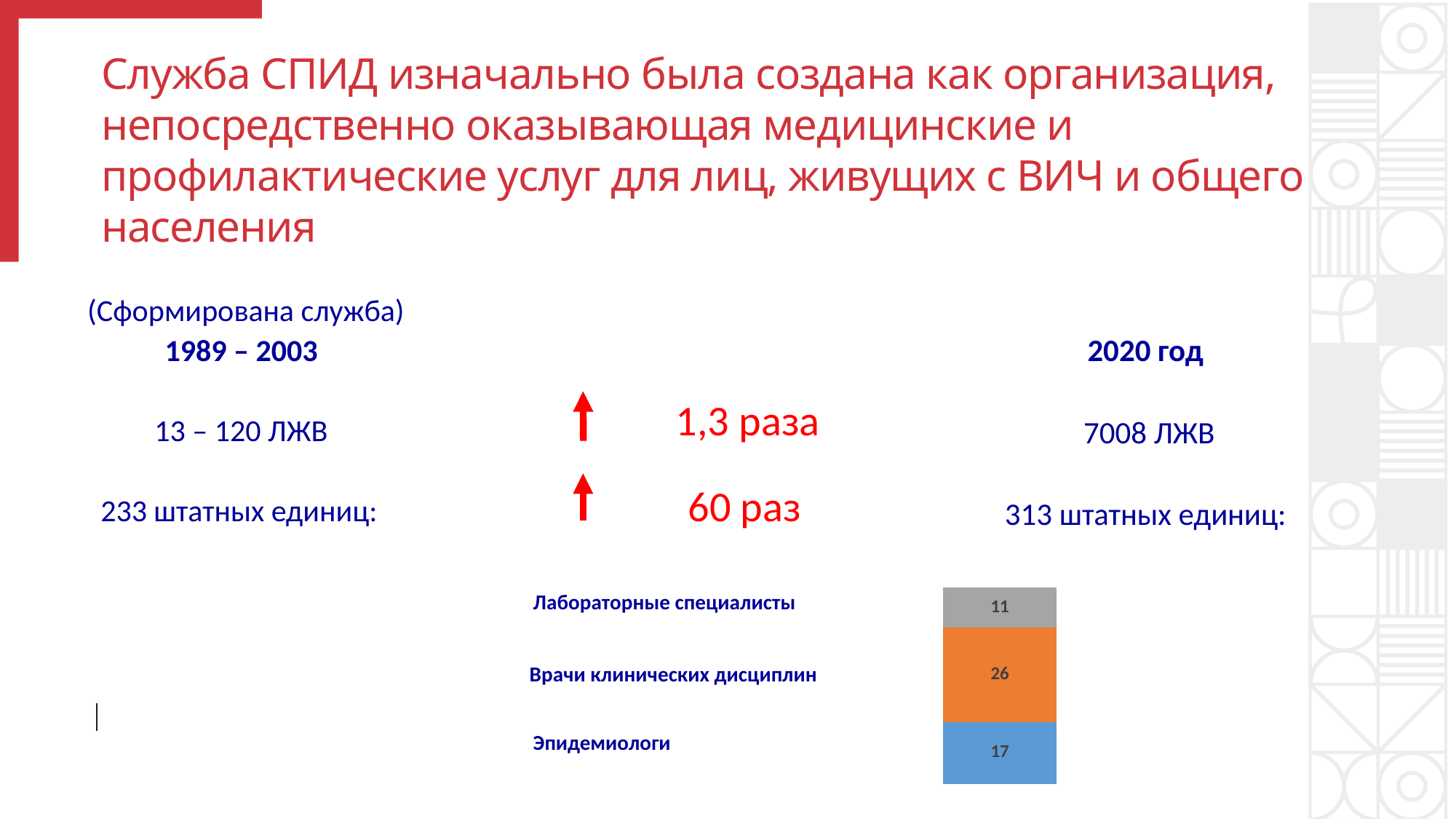
How many segments does the stacked bar contain? 3 What is the total of all segments in the stacked bar? 54 What is the difference between the Врачи клинических дисциплин value and the Эпидемиологи value? 9 What value is shown for the Лабораторные специалисты segment of the stacked bar? 11 What colour is the segment labelled 26 in the stacked bar? Orange What is the difference between the Эпидемиологи value and the Лабораторные специалисты value? 6 What value is shown for the Врачи клинических дисциплин segment of the stacked bar? 26 What kind of chart is shown at the bottom of the slide? Stacked bar chart What value is shown for the Эпидемиологи segment of the stacked bar? 17 Which segment of the stacked bar has the smallest value? Лабораторные специалисты Which is larger: the value for Эпидемиологи or the value for Лабораторные специалисты? Эпидемиологи Which segment of the stacked bar has the largest value? Врачи клинических дисциплин